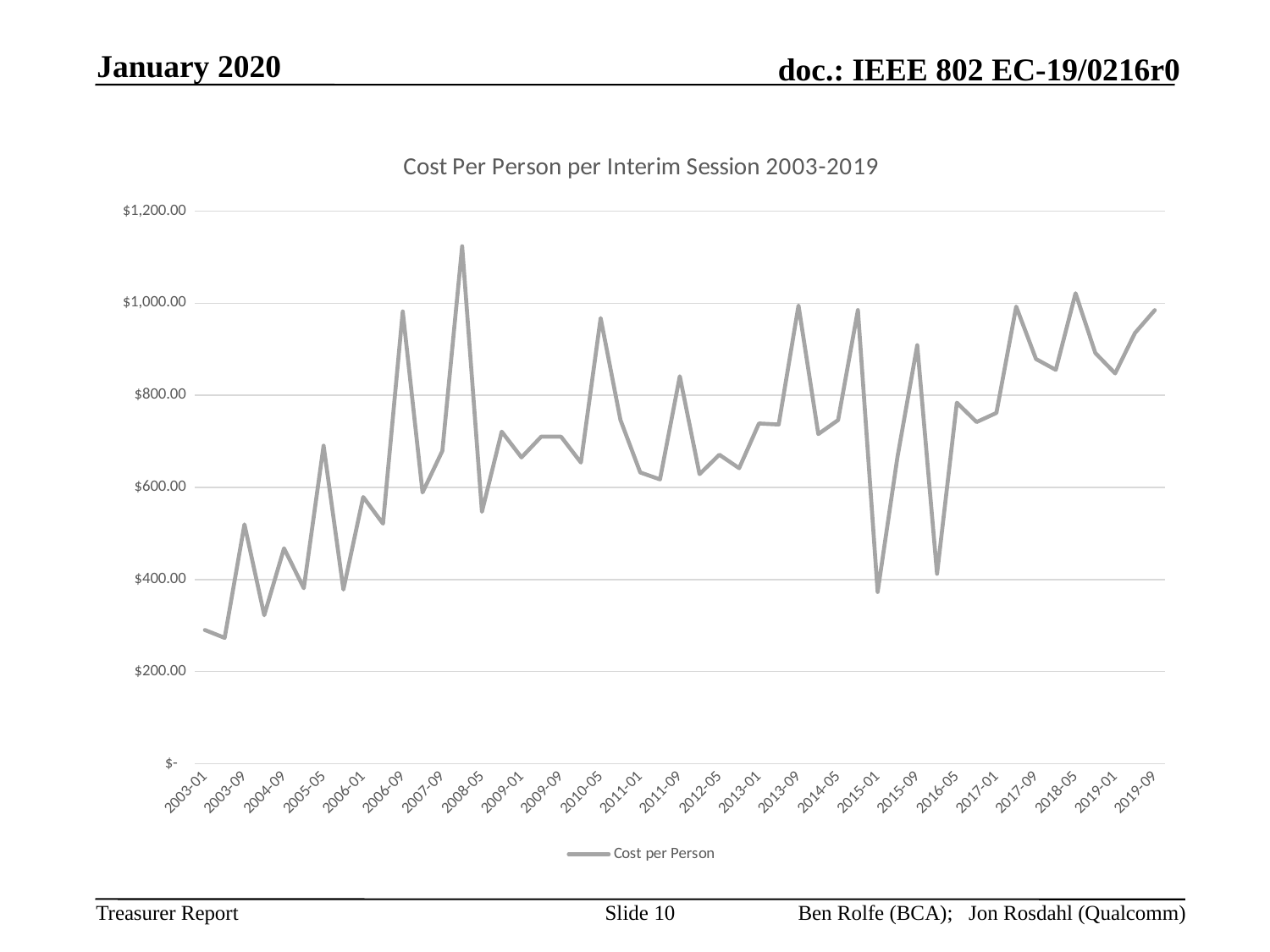
Which has the higher cost per person, 2003-01 or 2019-09? 2019-09 Is the value for 2013-09 greater or less than $800.00? greater Is the value for 2008-05 greater or less than $600.00? less What is the name of the series shown in the legend? Cost per Person What kind of chart is shown on the slide? Line chart Is the value for 2006-09 greater or less than $800.00? greater Overall, does the cost per person rise or fall from 2003-01 to 2019-09? Rise How many series does the legend list? 1 What is the title of the chart? Cost Per Person per Interim Session 2003-2019